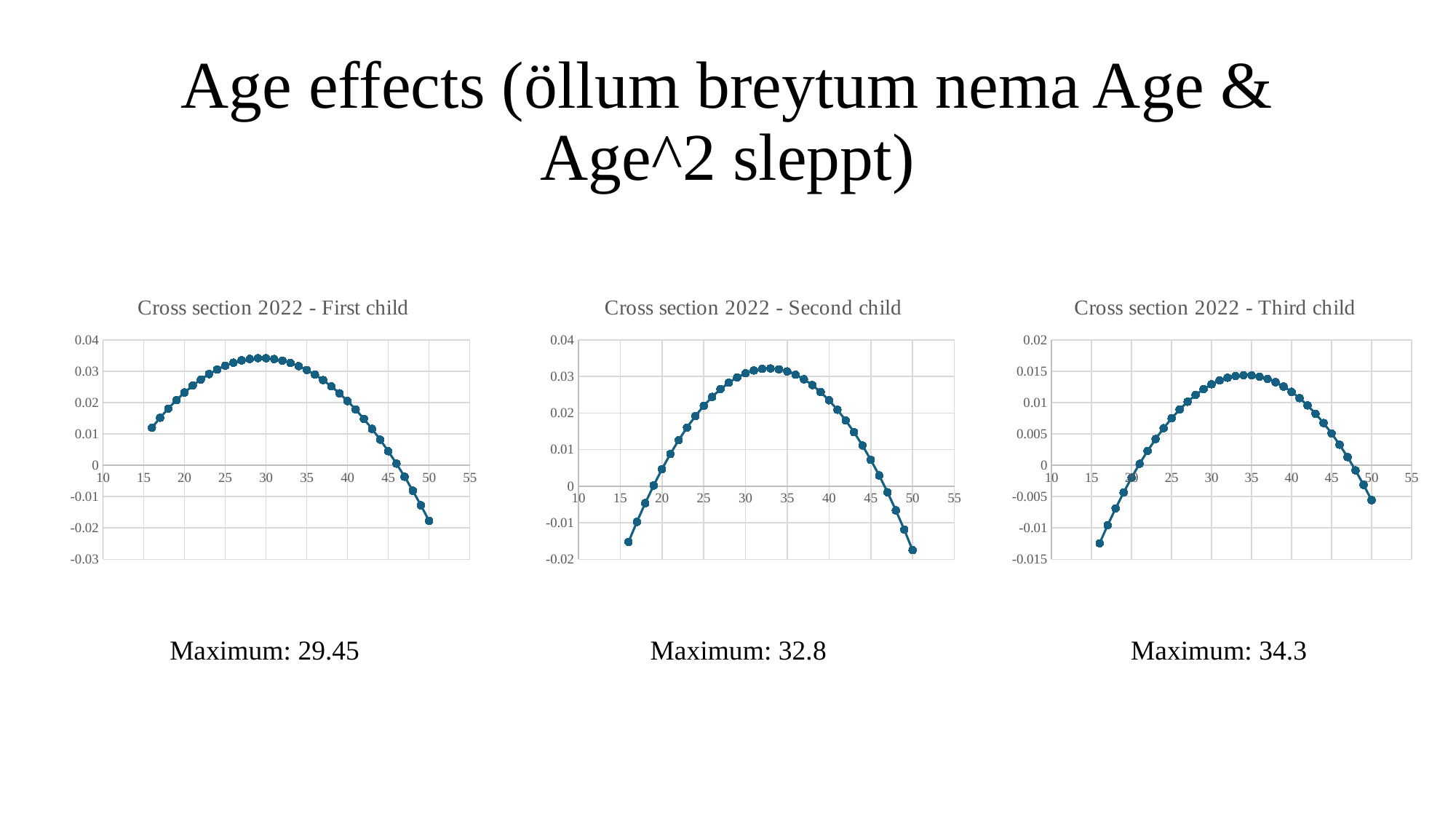
How many data series are plotted in the 'Cross section 2022 - First child' chart? 1 In the 'Cross section 2022 - Second child' chart, do the values rise or fall as age increases from 35 to 50? fall In the 'Cross section 2022 - First child' chart, is the value at age 50 greater or less than 0? less What is the title of the middle chart on the slide? Cross section 2022 - Second child What kind of chart is the 'Cross section 2022 - First child' chart? line chart In the 'Cross section 2022 - Third child' chart, is the value at age 50 greater or less than 0? less In the 'Cross section 2022 - Second child' chart, is the value at age 33 greater or less than 0.03? greater How many charts are shown on the slide? 3 In the 'Cross section 2022 - Third child' chart, do the values rise or fall as age increases from 16 to 30? rise